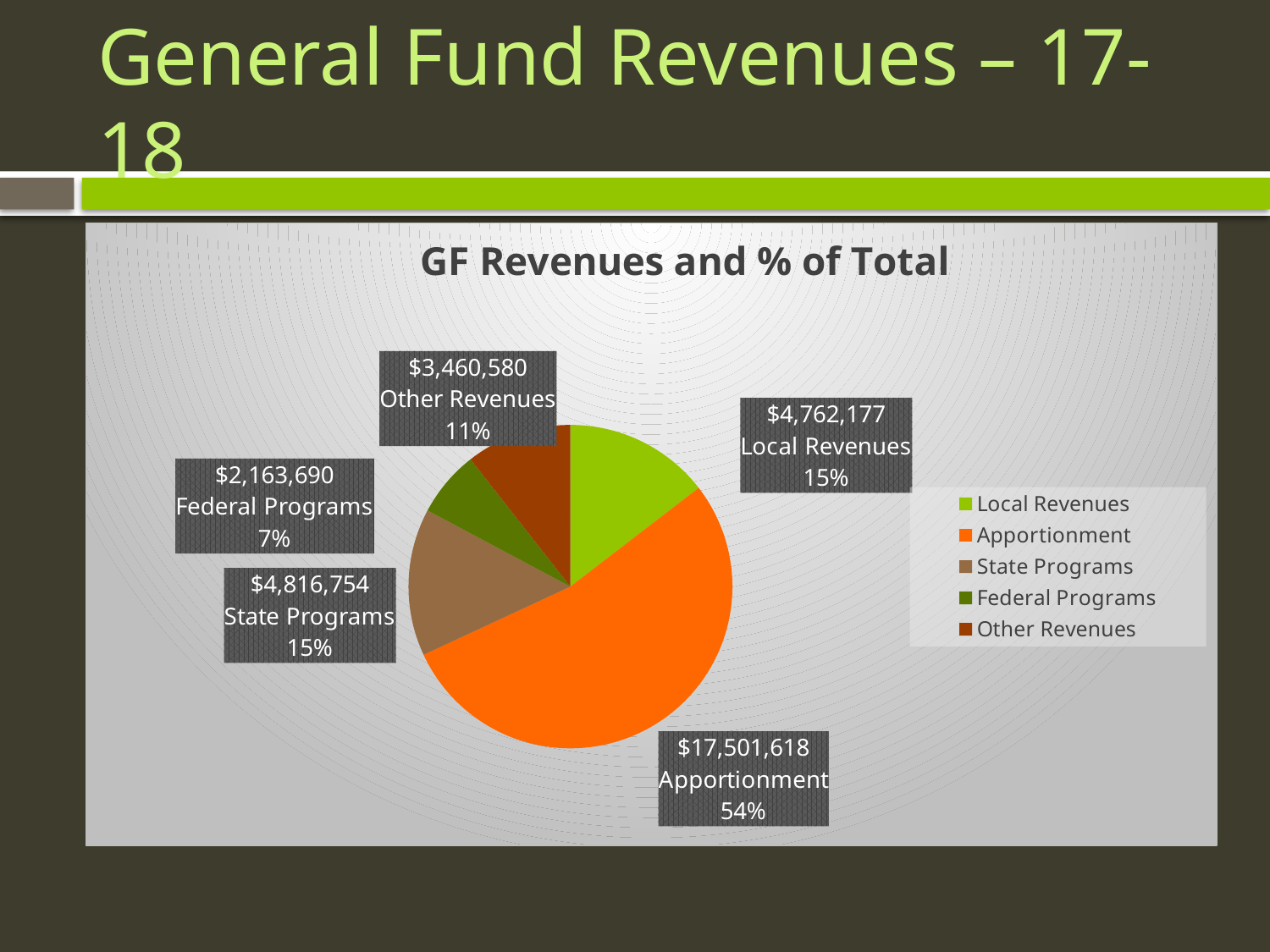
Which category has the largest share of the pie? Apportionment Which is larger, Other Revenues or Federal Programs? Other Revenues How many slices does the pie chart have? 5 What is the value for Federal Programs? $2,163,690 What percentage of the total does State Programs represent? 15% What is the difference between the Apportionment value and the State Programs value? $12,684,864 How many entries does the legend list? 5 What is the value for Apportionment? $17,501,618 What is the value for Other Revenues? $3,460,580 Which category has the smallest share of the pie? Federal Programs What is the title of the chart? GF Revenues and % of Total What type of chart is shown on the slide? Pie chart